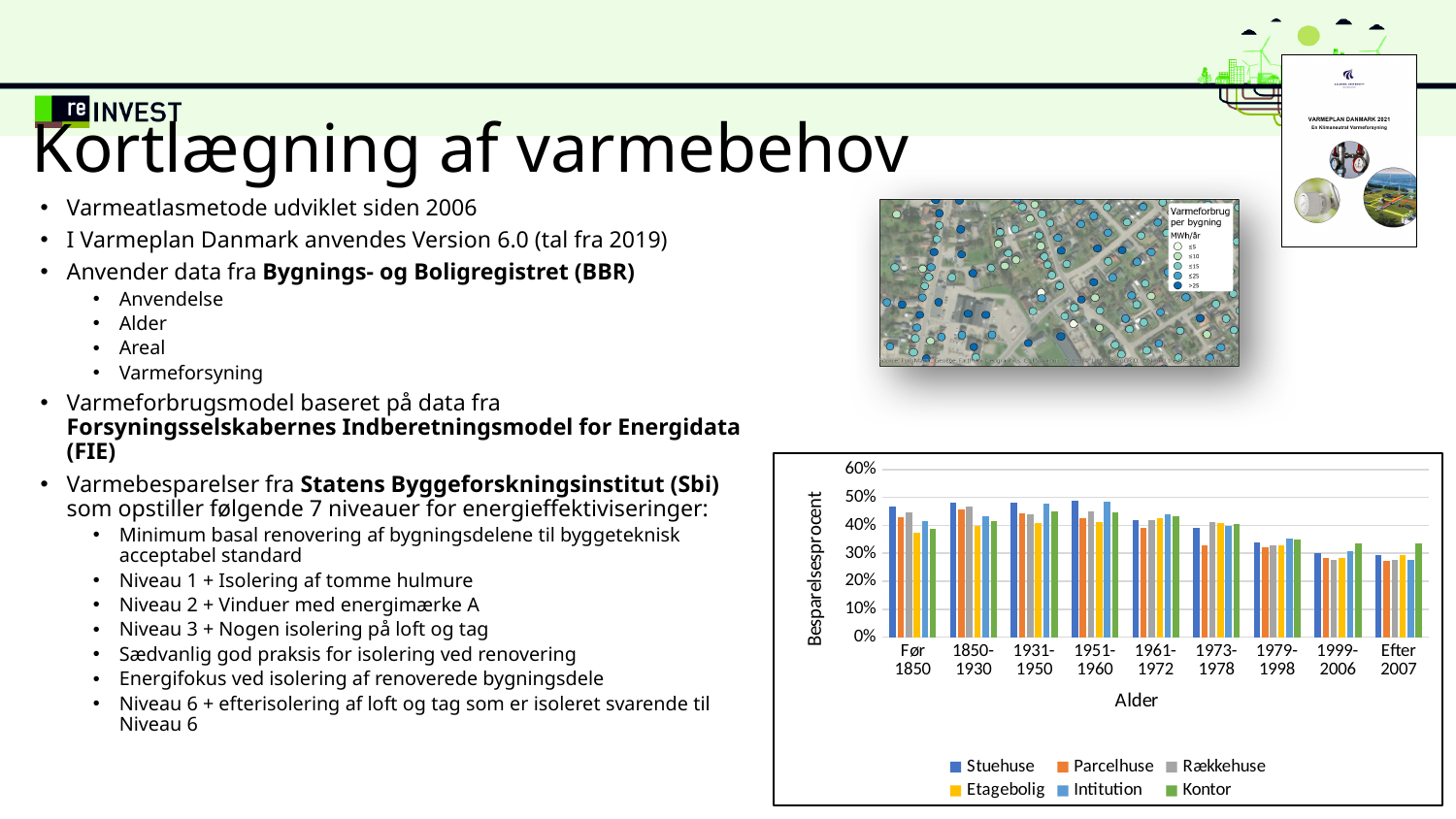
How many age categories (Alder) are shown on the x axis of the bar chart? 9 In the bar chart, is the value for Intitution in the '1979-1998' category greater or less than 30%? greater In the bar chart, which is larger: the Stuehuse value for 'Før 1850' or the Stuehuse value for 'Efter 2007'? Før 1850 How many series does the legend of the bar chart list? 6 In the bar chart, do the savings percentages generally rise or fall as the building age categories move from 'Før 1850' to 'Efter 2007'? Fall In the bar chart, is the value for Etagebolig in the '1999-2006' category greater or less than 30%? less In the bar chart, is the value for Stuehuse in the 'Før 1850' category greater or less than 40%? greater What kind of chart is shown at the bottom right of the slide? Bar chart What is the label of the vertical axis of the bar chart? Besparelsesprocent What is the label of the horizontal axis of the bar chart? Alder